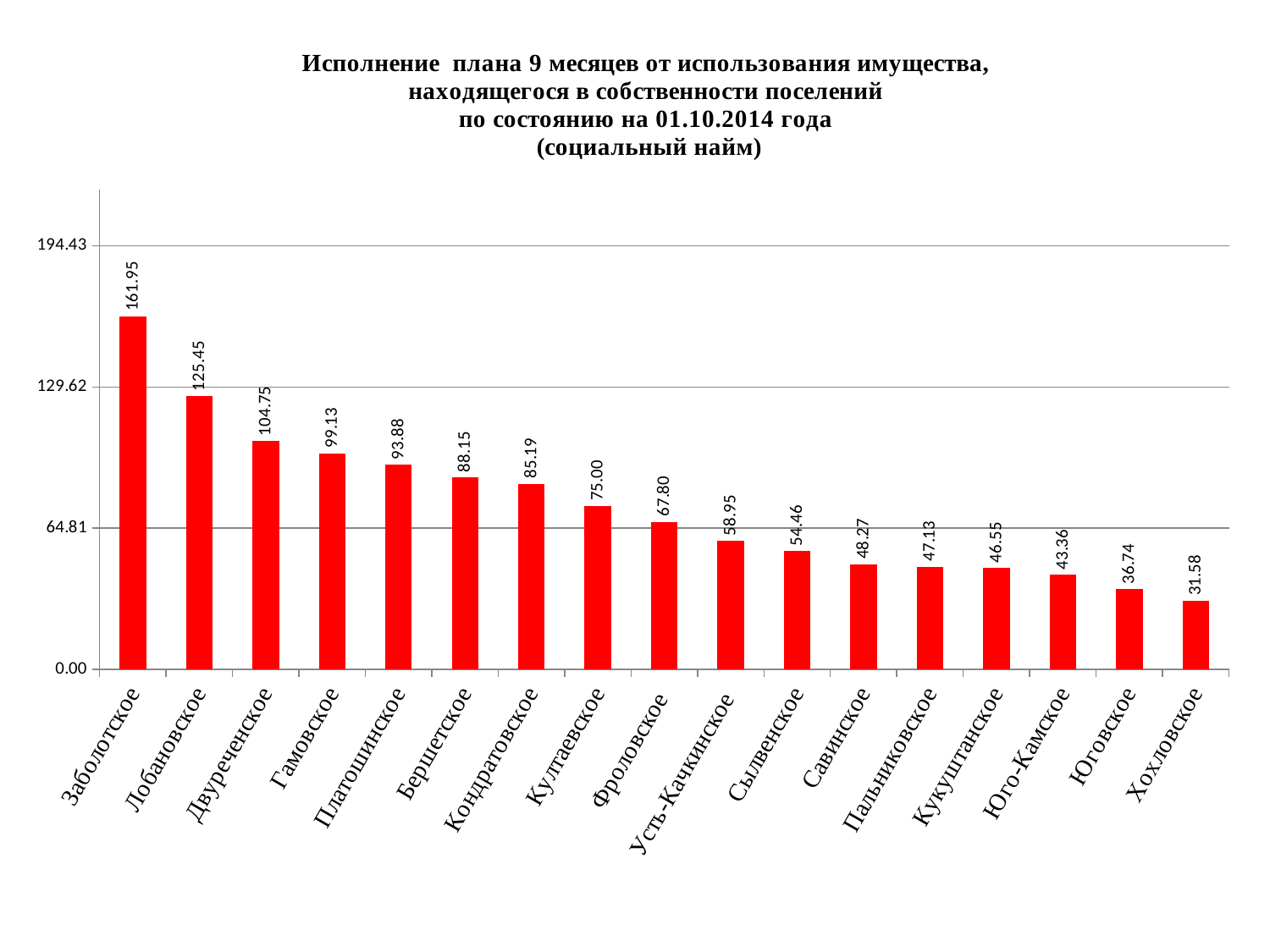
What is the difference between the values for Заболотское and Лобановское? 36.50 What colour are the bars? Red What kind of chart is this? Bar chart Which category has the lowest value? Хохловское Do the values rise or fall from left to right along the x axis? Fall Which category has the highest value? Заболотское What is the value for Усть-Качкинское? 58.95 How many categories are shown on the x axis? 17 What is the value for Заболотское? 161.95 What is the value for Хохловское? 31.58 Which is larger, the value for Гамовское or the value for Платошинское? Гамовское